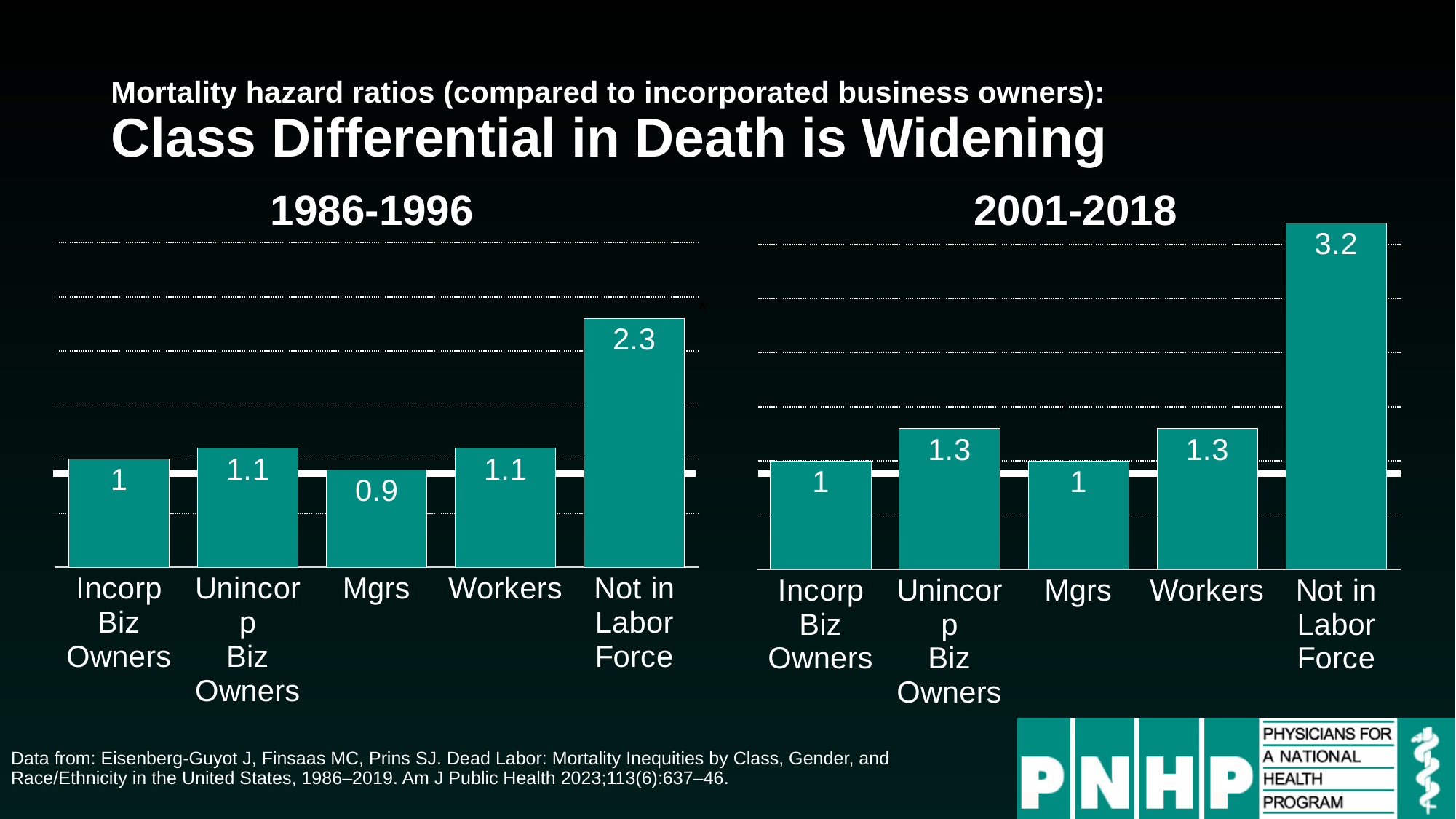
In the 2001-2018 chart, what is the difference between Workers and Incorp Biz Owners? 0.3 In the 2001-2018 chart, what is the mortality hazard ratio for Not in Labor Force? 3.2 In the 2001-2018 chart, what is the value for Workers? 1.3 In the 1986-1996 chart, which is larger, the value for Workers or the value for Mgrs? Workers In the 1986-1996 chart, which category has the lowest value? Mgrs How many categories are shown in the 2001-2018 chart? 5 What type of chart is the 1986-1996 chart? Bar chart In the 2001-2018 chart, which category has the highest value? Not in Labor Force What is the title of the chart on the right side of the slide? 2001-2018 What is the difference between the Not in Labor Force values in the 2001-2018 chart and the 1986-1996 chart? 0.9 In the 1986-1996 chart, what is the mortality hazard ratio for Not in Labor Force? 2.3 In the 1986-1996 chart, what is the value for Mgrs? 0.9